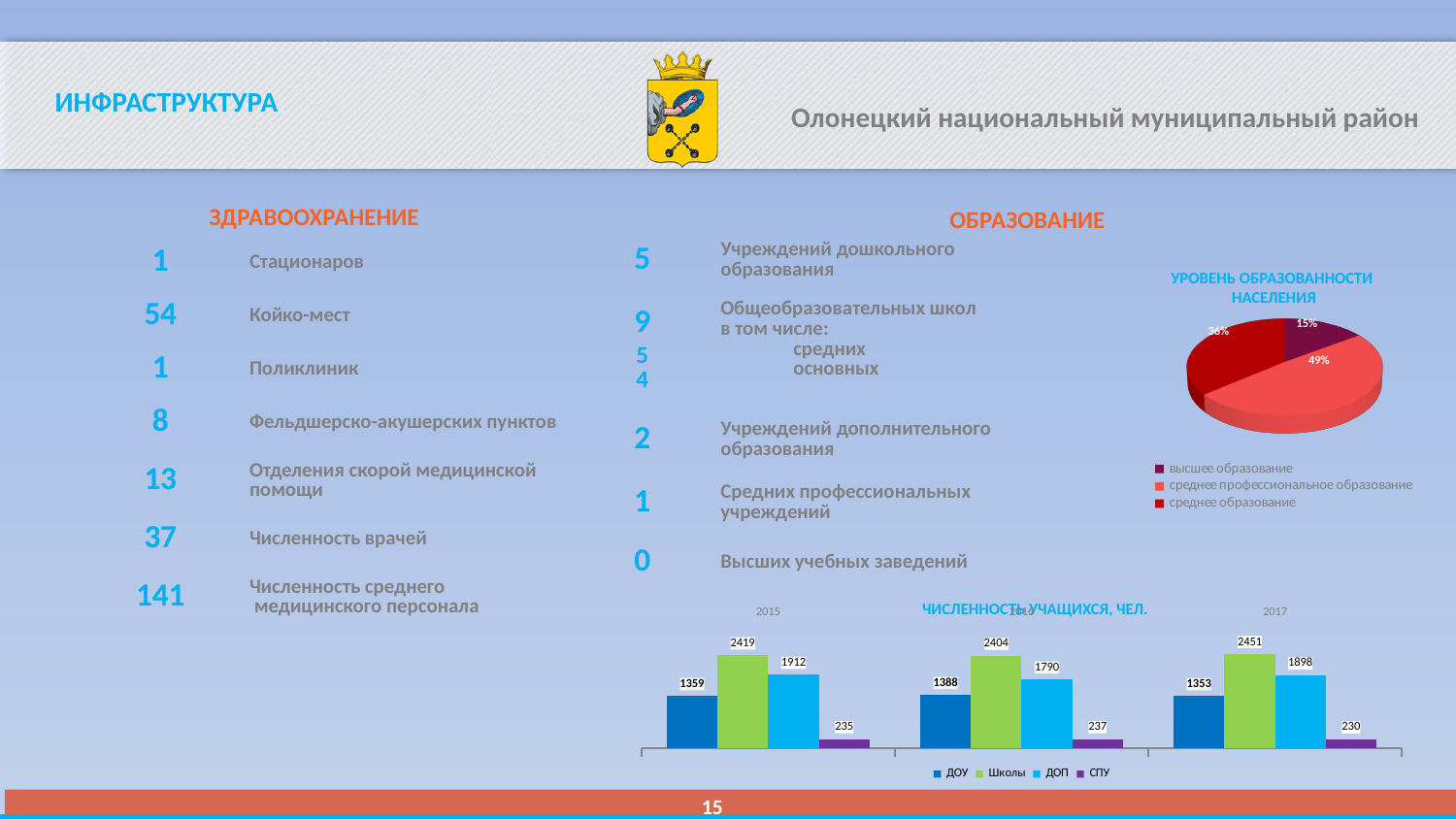
In the bar chart 'ЧИСЛЕННОСТЬ УЧАЩИХСЯ, ЧЕЛ.', is the ДОП value larger in 2015 or in 2017? 2015 In the bar chart 'ЧИСЛЕННОСТЬ УЧАЩИХСЯ, ЧЕЛ.', what is the value for ДОУ in 2015? 1359 In the bar chart 'ЧИСЛЕННОСТЬ УЧАЩИХСЯ, ЧЕЛ.', which series has the lowest value in every year? СПУ In the pie chart 'УРОВЕНЬ ОБРАЗОВАННОСТИ НАСЕЛЕНИЯ', what is the share of the largest slice? 49% In the bar chart 'ЧИСЛЕННОСТЬ УЧАЩИХСЯ, ЧЕЛ.', what is the difference between the Школы value and the ДОП value in 2015? 507 In the bar chart 'ЧИСЛЕННОСТЬ УЧАЩИХСЯ, ЧЕЛ.', what is the value for СПУ in 2016? 237 In the pie chart 'УРОВЕНЬ ОБРАЗОВАННОСТИ НАСЕЛЕНИЯ', what is the share of the smallest slice? 15% How many series does the legend of the bar chart 'ЧИСЛЕННОСТЬ УЧАЩИХСЯ, ЧЕЛ.' list? 4 In the bar chart 'ЧИСЛЕННОСТЬ УЧАЩИХСЯ, ЧЕЛ.', which series has the highest value in 2016? Школы How many years are shown on the x axis of the bar chart 'ЧИСЛЕННОСТЬ УЧАЩИХСЯ, ЧЕЛ.'? 3 In the bar chart 'ЧИСЛЕННОСТЬ УЧАЩИХСЯ, ЧЕЛ.', what is the value for Школы in 2017? 2451 What kind of chart is 'УРОВЕНЬ ОБРАЗОВАННОСТИ НАСЕЛЕНИЯ'? pie chart